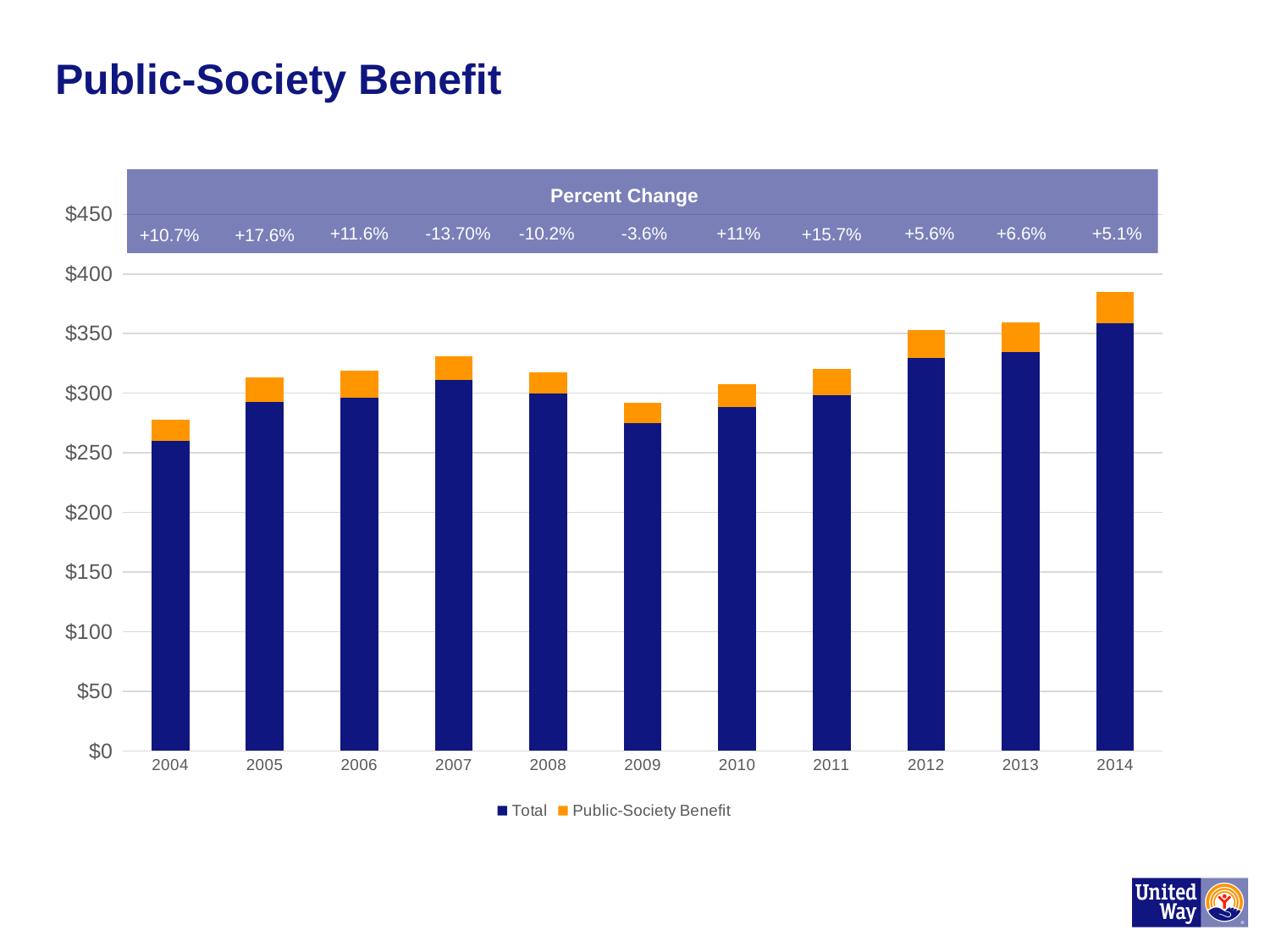
What kind of chart is shown on the slide? Stacked bar chart What is the percent change shown for 2007? -13.70% Which year has the highest percent change in the Percent Change row? 2005 How many series does the chart's legend list? 2 Which year has the lowest percent change in the Percent Change row? 2007 Is the top of the stacked bar for 2004 greater or less than $300? less What is the percent change shown for 2011? +15.7% What is the percent change shown for 2005? +17.6% How many years are shown along the x axis of the chart? 11 What are the two series named in the chart's legend? Total and Public-Society Benefit Which year has the tallest stacked bar? 2014 Is the top of the stacked bar for 2014 greater or less than $350? greater